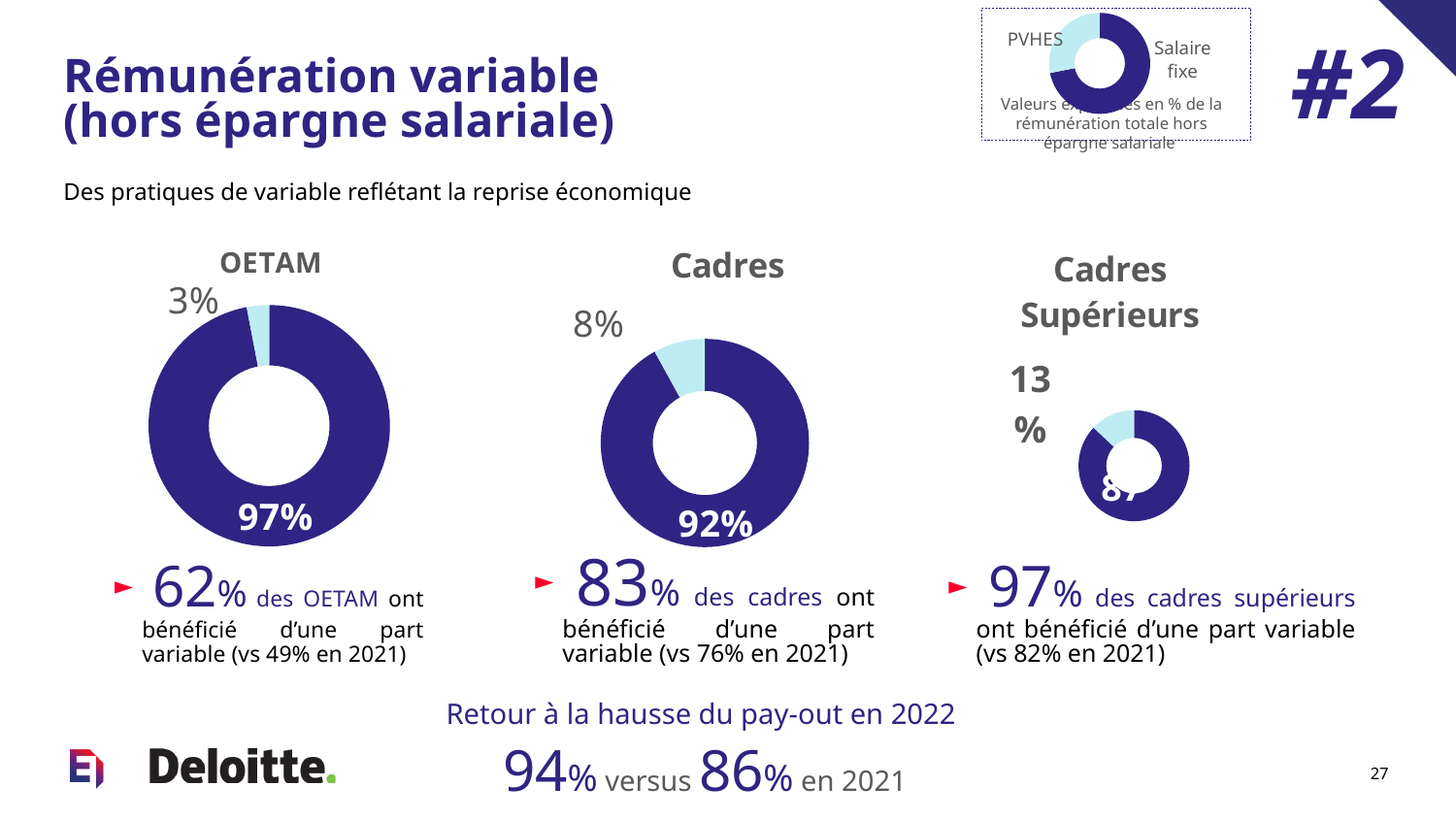
In the Cadres chart, what percentage does the dark blue slice represent? 92% In the OETAM chart, what percentage does the small light blue slice represent? 3% In the Cadres Supérieurs chart, what percentage does the light blue slice represent? 13% Which of the three groups has the smallest light blue (variable) share? OETAM In the OETAM chart, what percentage does the large dark blue slice represent? 97% What is the difference between the light blue share in the Cadres chart and the light blue share in the OETAM chart? 5% In the small legend chart at the top right, what are the two categories named? PVHES and Salaire fixe What type of chart is used for OETAM, Cadres and Cadres Supérieurs? Donut (pie) chart How many donut charts are shown in the main body of the slide (excluding the small legend chart at the top right)? 3 Which of the three groups has the largest light blue (variable) share: OETAM, Cadres or Cadres Supérieurs? Cadres Supérieurs In the Cadres chart, what percentage does the light blue slice represent? 8% Is the light blue share larger in the Cadres chart or in the OETAM chart? Cadres